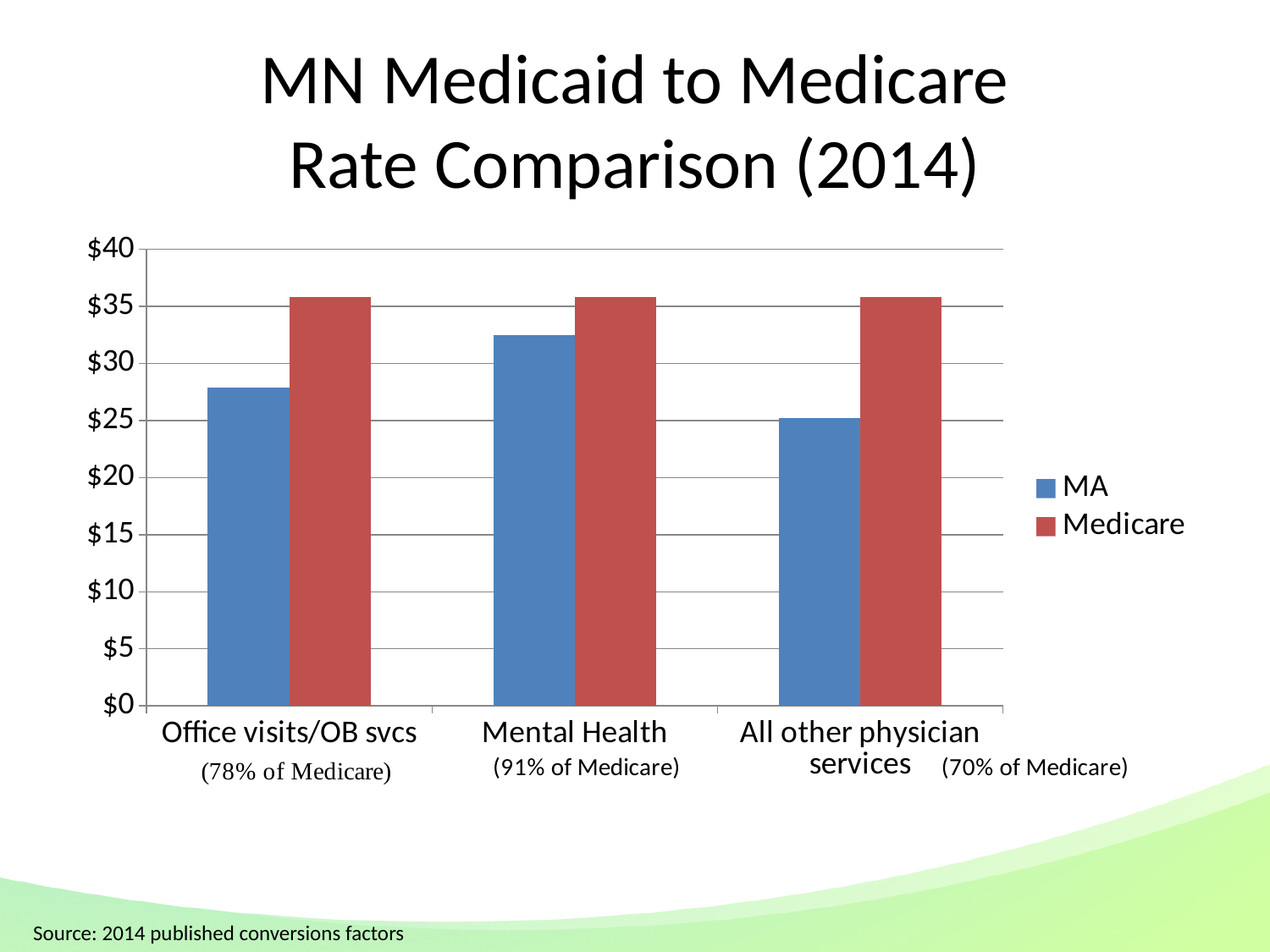
Is the Medicare value for Office visits/OB svcs greater or less than $30? greater For Mental Health, which is larger: the MA value or the Medicare value? Medicare Is the MA value for Mental Health greater or less than $30? greater Which category has the lowest MA value? All other physician services Which category has the highest MA value? Mental Health How many series does the chart's legend list? 2 How many categories are shown on the x axis of the chart? 3 Is the MA value for All other physician services greater or less than $30? less What kind of chart is shown on the slide? bar chart What is the title of the chart on the slide? MN Medicaid to Medicare Rate Comparison (2014) Which colour represents the Medicare series in the chart? red